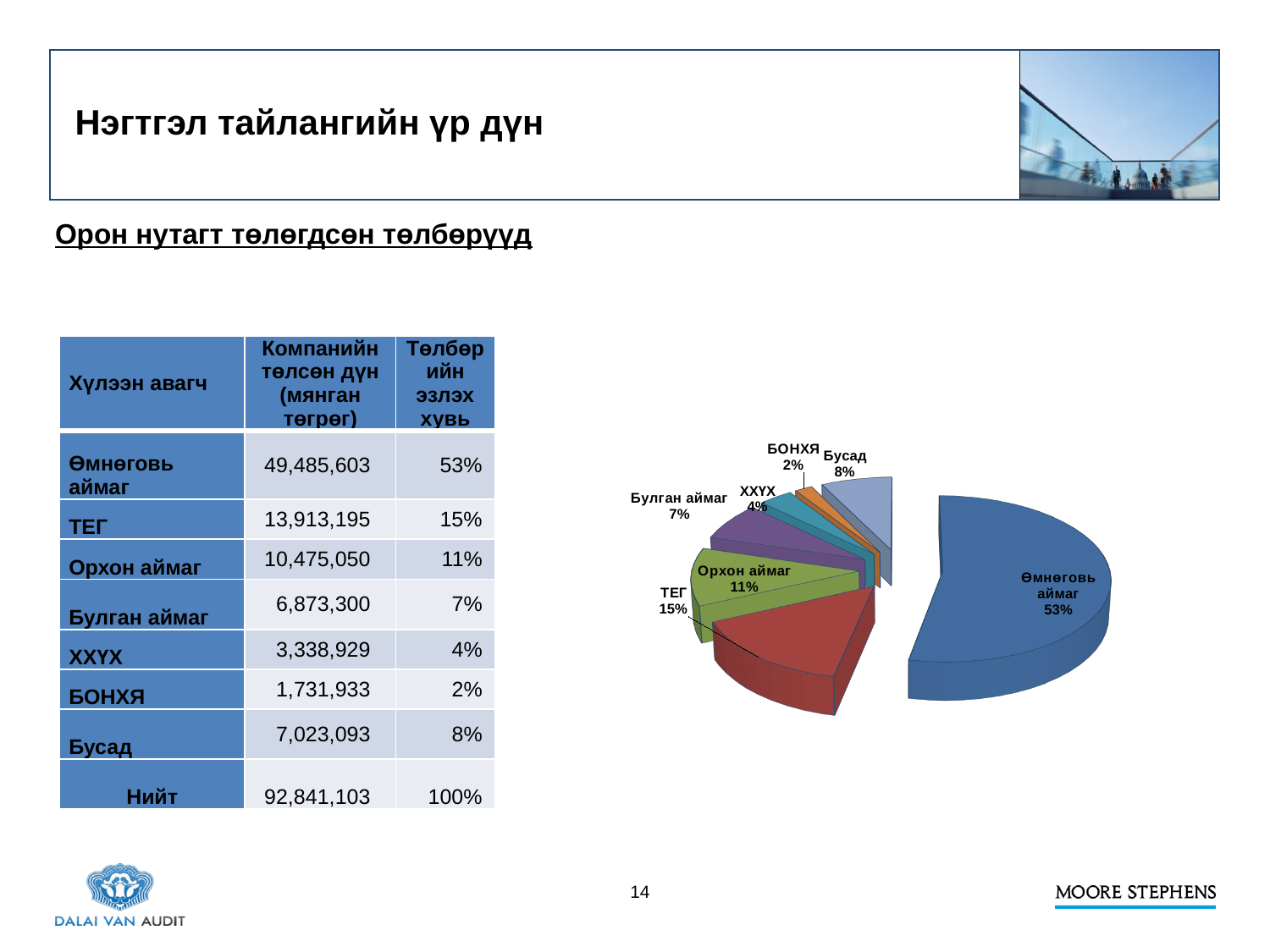
What is the difference in percentage points between the Өмнөговь аймаг slice and the ТЕГ slice? 38 What share of the pie does ТЕГ hold? 15% Which slice is larger, Бусад or Булган аймаг? Бусад Which slice of the pie chart is the largest? Өмнөговь аймаг Which slice of the pie chart is the smallest? БОНХЯ What share of the pie does Бусад hold? 8% What kind of chart is shown on the slide? pie chart What share of the pie does Өмнөговь аймаг hold? 53% What is the combined share of the ХХҮХ and БОНХЯ slices? 6% How many slices does the pie chart have? 7